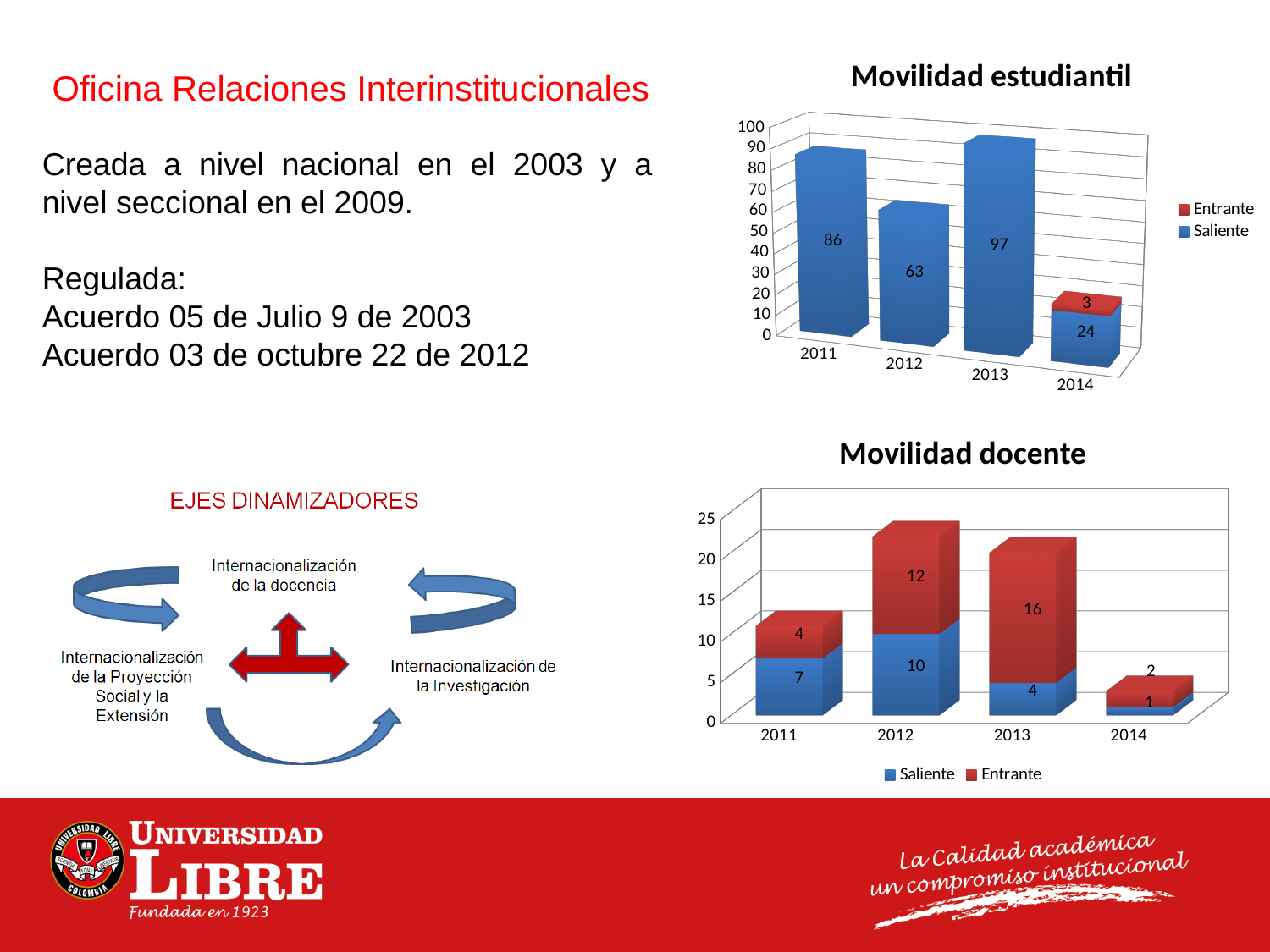
In the 'Movilidad docente' chart, which year has the lowest Saliente value? 2014 In the 'Movilidad docente' chart, what is the Entrante value for 2013? 16 In the 'Movilidad docente' chart, what is the total of the stacked bar for 2012? 22 In the 'Movilidad estudiantil' chart, what is the Saliente value for 2013? 97 What kind of chart is 'Movilidad docente'? Bar chart In the 'Movilidad estudiantil' chart, which year has the highest Saliente value? 2013 In the 'Movilidad estudiantil' chart, what is the total of the stacked bar for 2014? 27 In the 'Movilidad docente' chart, is the Entrante value for 2011 or for 2013 larger? 2013 In the 'Movilidad estudiantil' chart, what is the Entrante value for 2014? 3 In the 'Movilidad estudiantil' chart, how many series does the legend list? 2 In the 'Movilidad estudiantil' chart, what is the difference between the Saliente values for 2011 and 2012? 23 In the 'Movilidad docente' chart, what is the Saliente value for 2012? 10